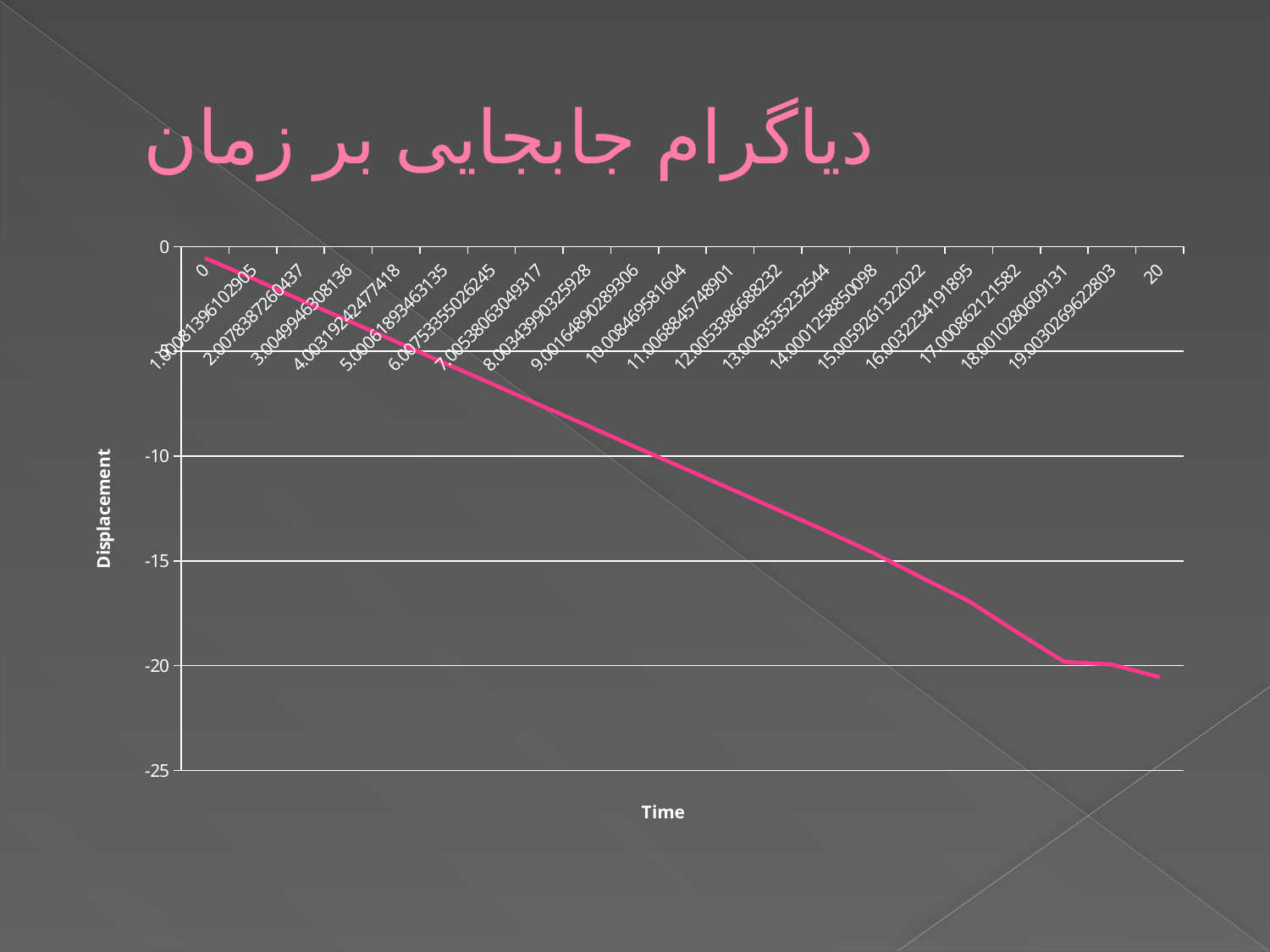
Is the displacement value at time 12.0053386688232 greater or less than -15? greater Is the displacement value at time 17.0008621121582 greater or less than -15? less Do the displacement values rise or fall as time increases along the x axis? fall What is the title of the vertical axis? Displacement Is the displacement value at time 3.00499468308136 greater or less than -5? greater What is the title of the horizontal axis? Time What kind of chart is shown on the slide? line chart At which time value is the displacement lowest? 20 At which time value is the displacement highest? 0 How many data points are plotted on the line? 21